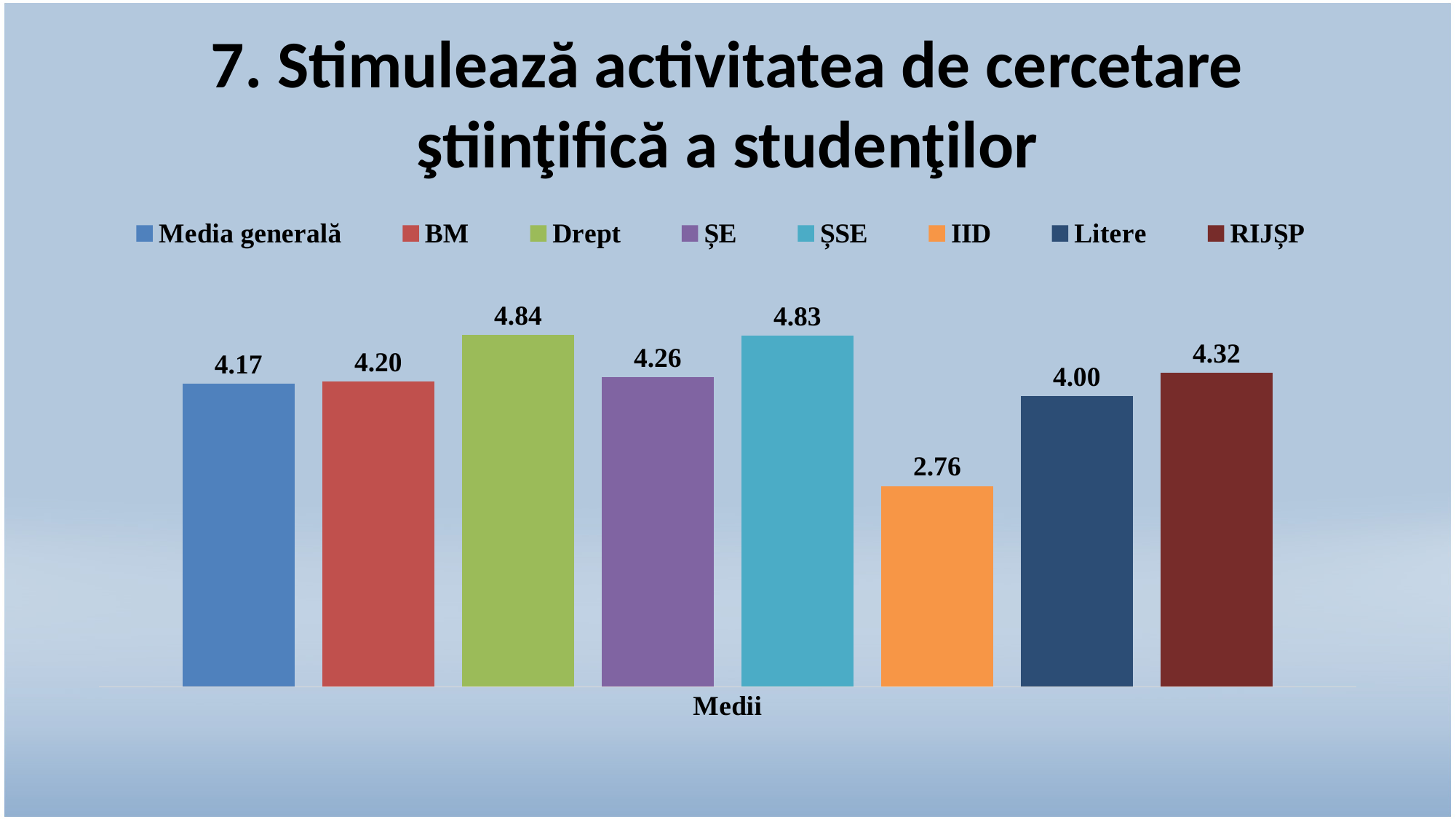
What is the value for Media generală? 4.17 What is the difference between the values for Drept and IID? 2.08 Which is larger, the value for ȘE or the value for BM? ȘE What is the label shown on the x axis below the bars? Medii What is the value for Litere? 4.00 What kind of chart is shown on the slide? Bar chart What is the value for IID? 2.76 Which series has the lowest value? IID What is the value for Drept? 4.84 How many series does the legend list? 8 Which series has the highest value? Drept What is the difference between the values for RIJȘP and Litere? 0.32